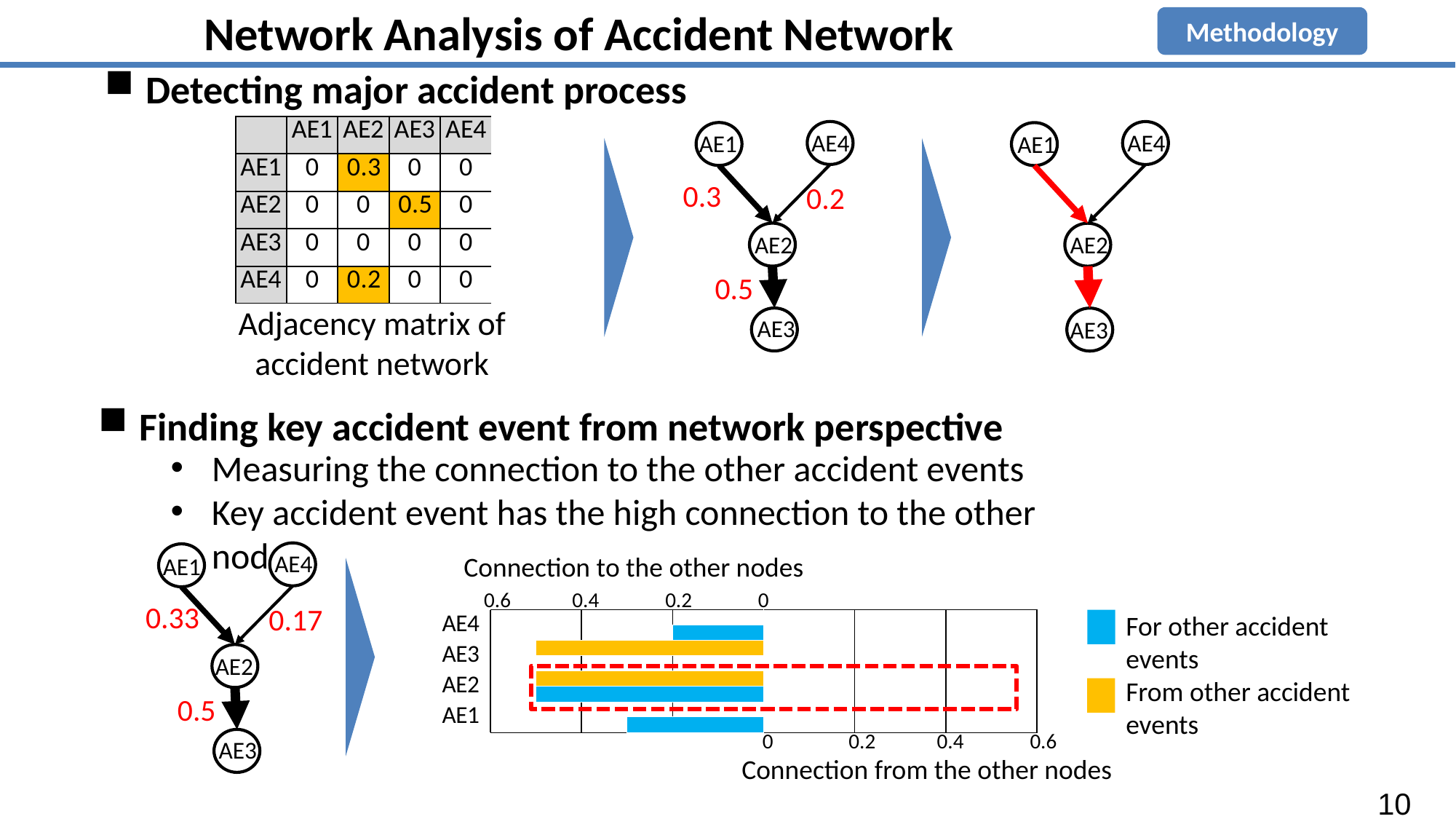
In the bar chart, which is larger: the 'From other accident events' value for AE3 or the 'For other accident events' value for AE1? AE3 'From other accident events' In the bar chart, which is larger: the 'For other accident events' value for AE2 or for AE4? AE2 In the bar chart, is the 'For other accident events' value for AE4 greater or less than 0.4? less In the bar chart, is the 'For other accident events' value for AE1 greater or less than 0.2? greater How many accident event categories are plotted in the bar chart? 4 Which category in the bar chart is highlighted with a red dashed box? AE2 Which colour represents 'For other accident events' in the bar chart legend? blue What kind of chart is shown at the bottom of the slide? bar chart In the bar chart, is the 'From other accident events' value for AE2 greater or less than 0.4? greater How many series does the bar chart legend list? 2